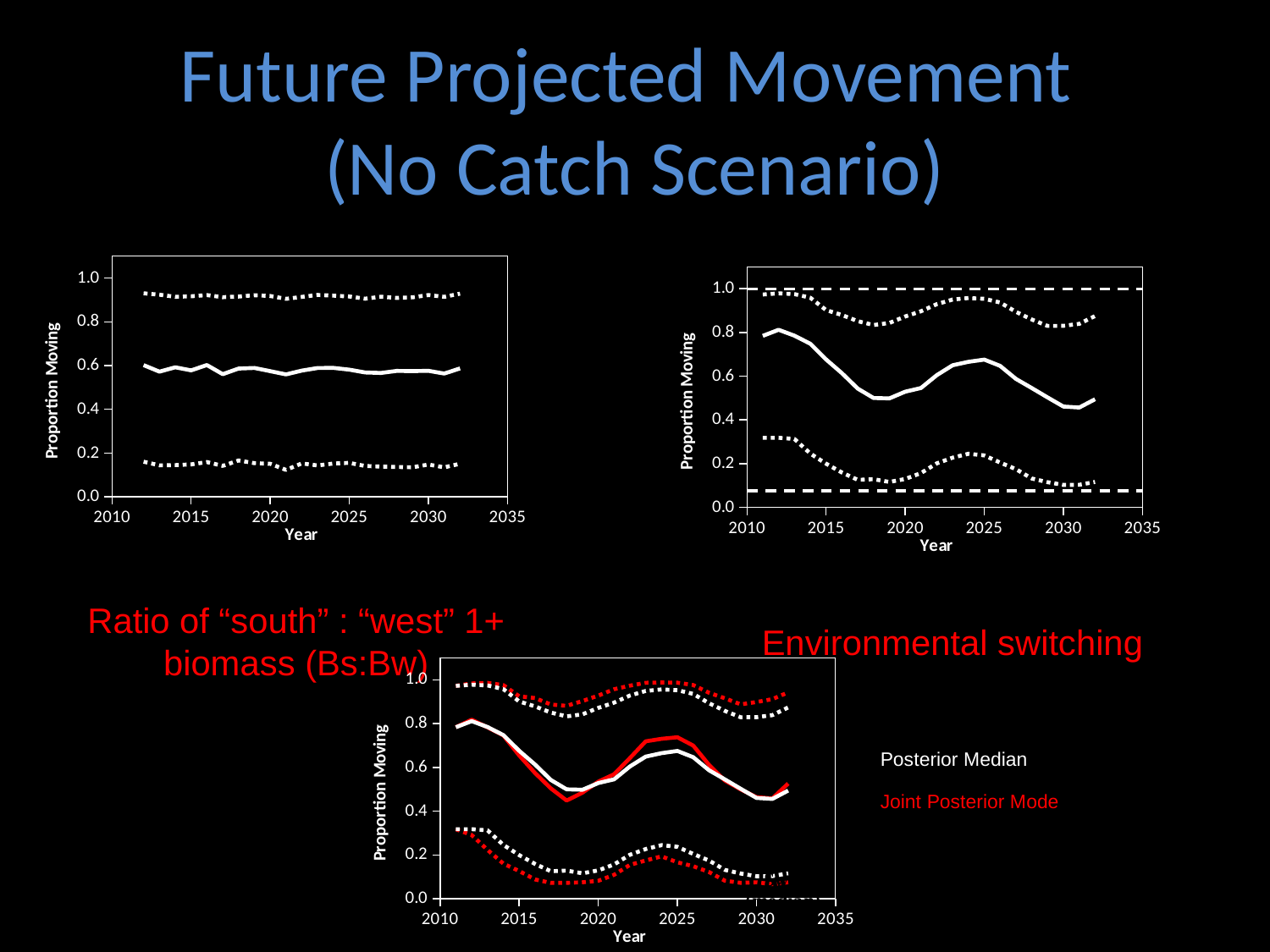
In the top-right chart, is the value of the solid line in 2011 greater or less than 0.6? greater In the top-right chart, does the solid line rise or fall between 2012 and 2018? fall In the bottom chart, is the value of the lower red dotted line in 2018 greater or less than 0.2? less What kind of chart is the top-left chart on the slide? line chart What is the y-axis label of the top-right chart? Proportion Moving In the top-left chart, does the solid line rise, fall, or stay roughly flat from 2012 to 2032? stays roughly flat In the top-left chart, is the value of the lower dotted line in 2025 greater or less than 0.2? less In the bottom chart, which line is higher around 2024, the red solid line or the white solid line? the red solid line In the bottom chart, what does the red line represent according to the legend? Joint Posterior Mode How many charts are shown on the slide? 3